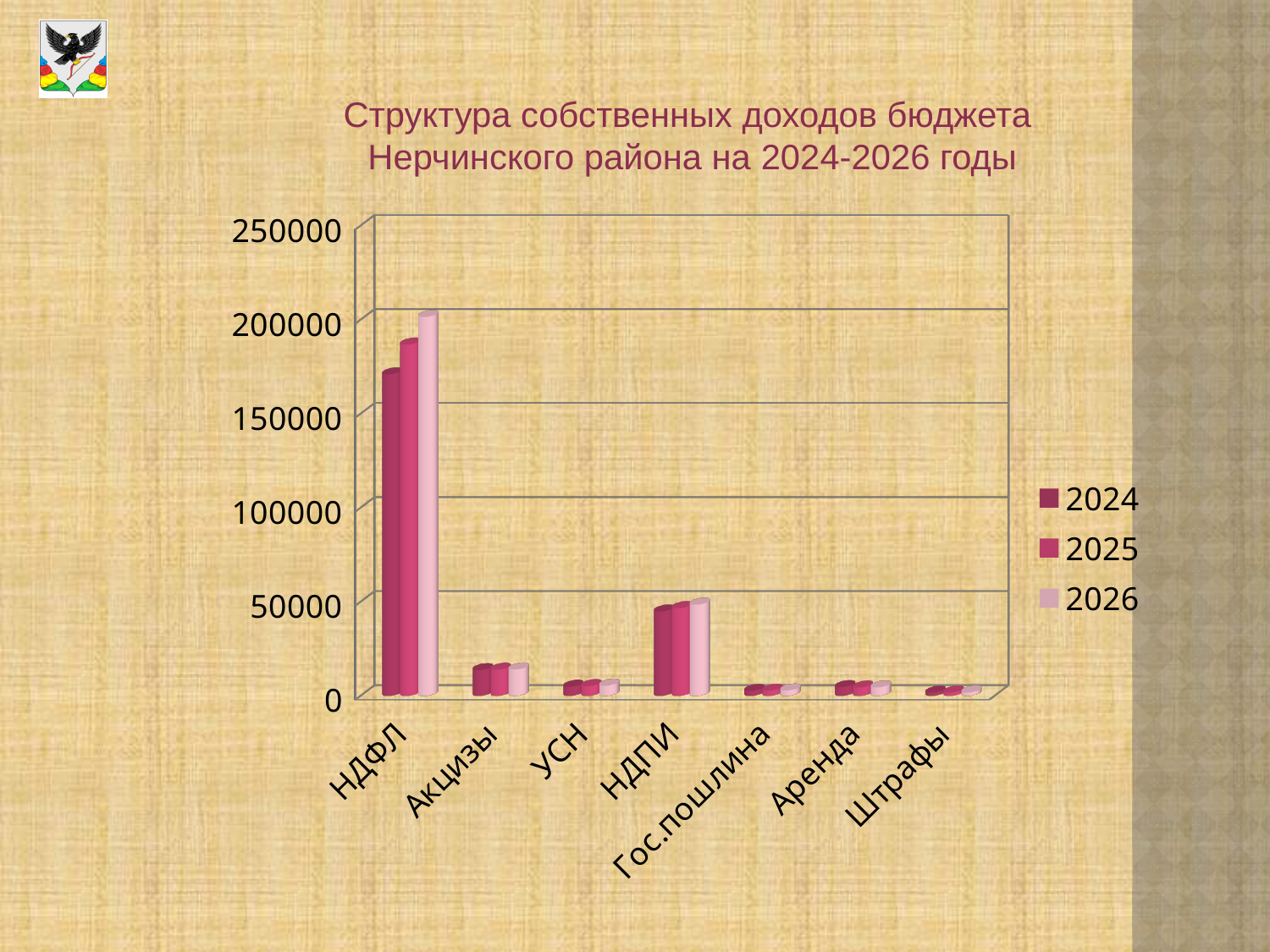
Is the value for НДПИ in 2025 greater or less than 100000? less Which is larger, the value for Акцизы or the value for УСН in 2024? Акцизы How many series does the chart's legend list? 3 What is the title of the chart? Структура собственных доходов бюджета Нерчинского района на 2024-2026 годы Which is larger, the value for НДФЛ or the value for НДПИ in 2026? НДФЛ Which category has the highest values in the chart? НДФЛ Do the values for НДФЛ rise or fall from 2024 to 2026? rise Is the value for НДФЛ in 2024 greater or less than 150000? greater What years are listed in the chart's legend? 2024, 2025, 2026 What kind of chart is shown on the slide? bar chart Is the value for Акцизы in 2026 greater or less than 50000? less How many categories are shown on the x axis of the chart? 7